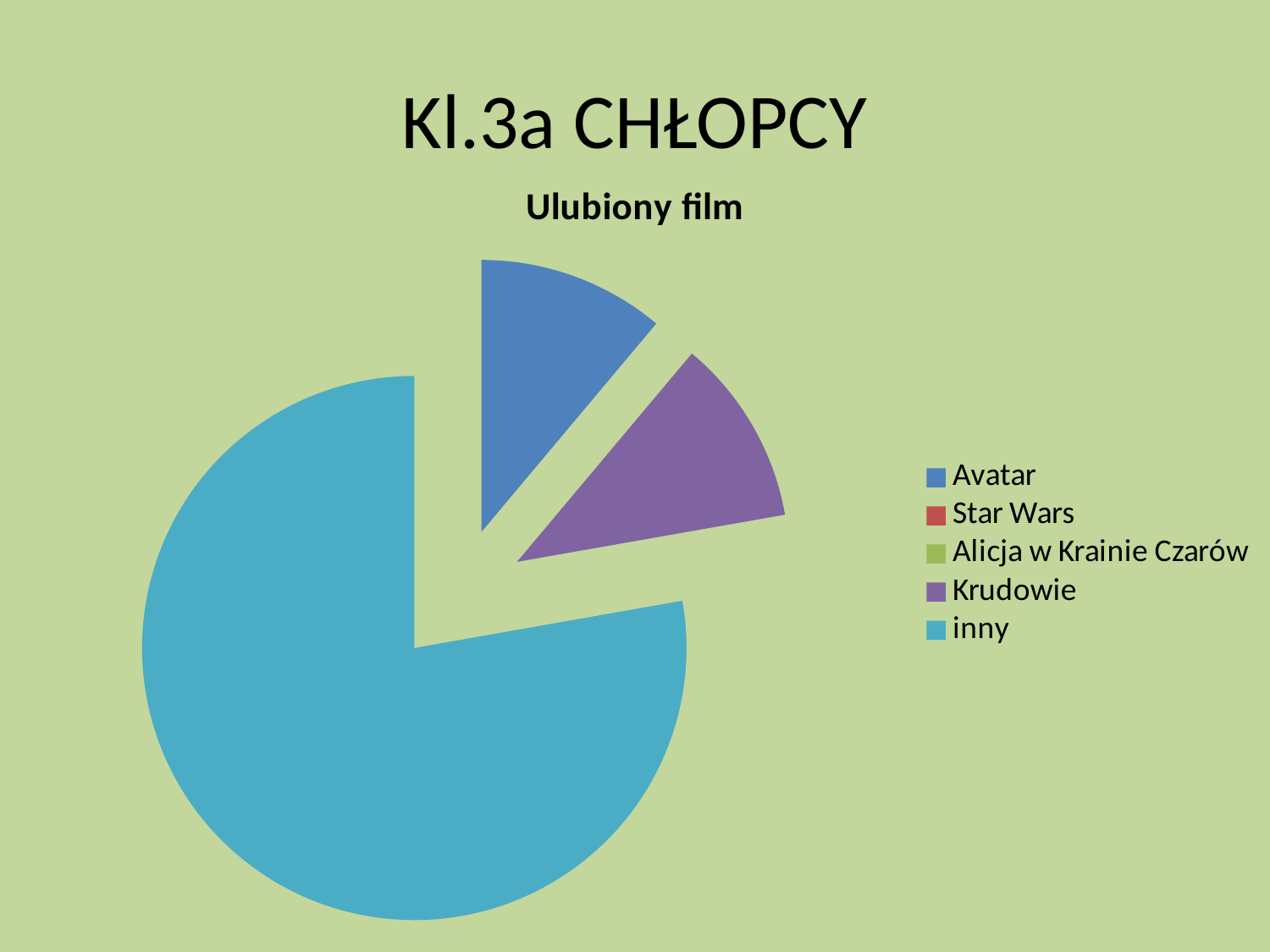
How many entries does the chart legend list? 5 What kind of chart is shown on the slide? pie chart Which category has the largest slice of the pie? inny Which colour represents Krudowie in the chart? purple Which slice is larger, inny or Avatar? inny How many slices are visibly drawn in the pie? 3 Does the slice for inny cover more or less than half of the pie? more Which slice is larger, Krudowie or inny? inny What is the title of the chart? Ulubiony film